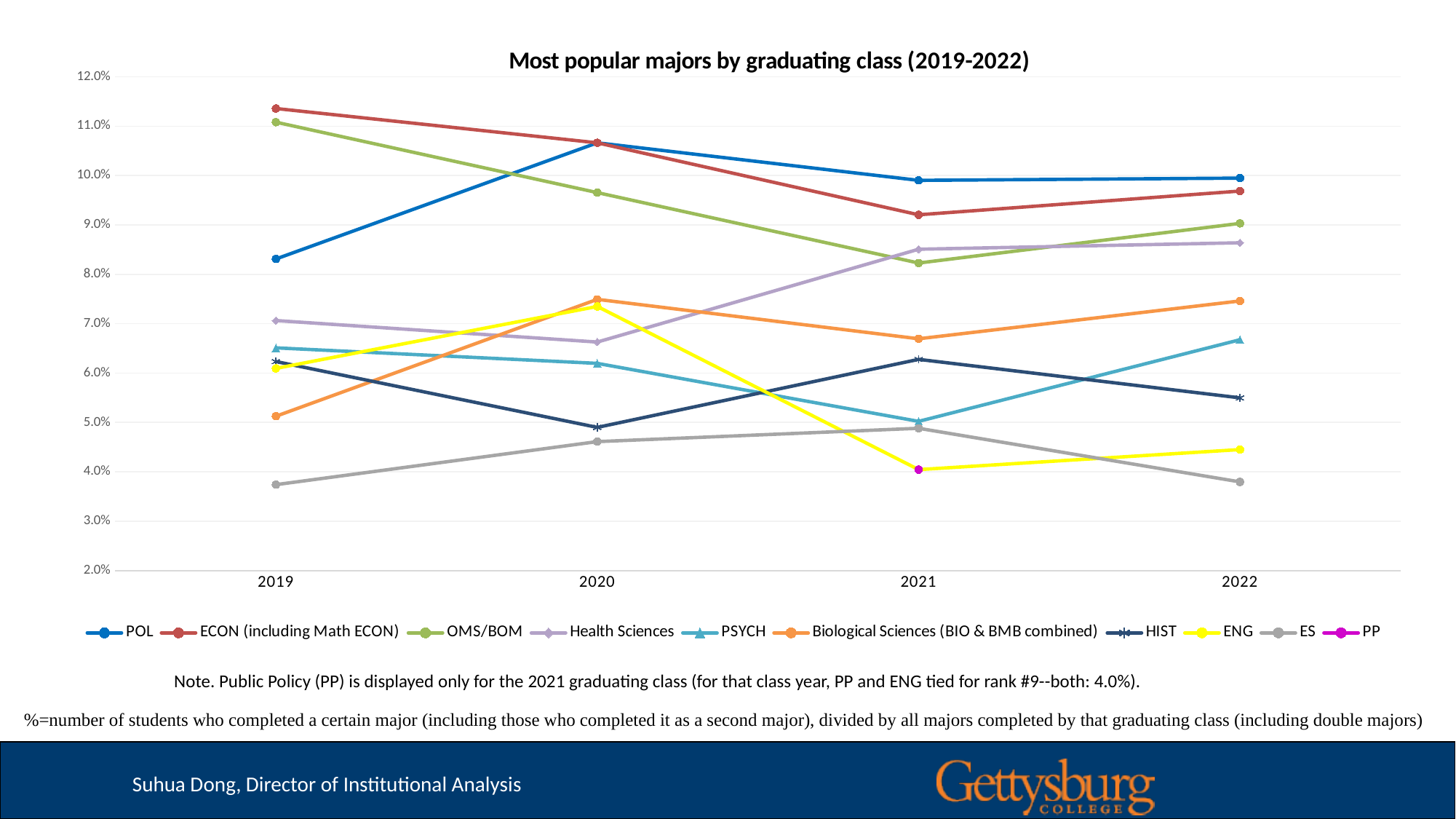
What is the value for PP (Public Policy) for the 2021 graduating class? 4.0% How many series does the legend list? 10 What type of chart is shown on the slide? line chart Which major has the lowest value for the 2019 graduating class? ES Is the value for POL in 2019 greater or less than 9.0%? less Is the value for PSYCH in 2022 greater or less than 6.0%? greater Does the value for ECON (including Math ECON) rise or fall from 2019 to 2021? fall Which major has the lowest value for the 2022 graduating class? ES How many graduating class years are plotted on the x axis? 4 Which major has the highest value for the 2021 graduating class? POL In 2020, which is larger: OMS/BOM or Health Sciences? OMS/BOM Is the value for Biological Sciences (BIO & BMB combined) in 2019 greater or less than 6.0%? less